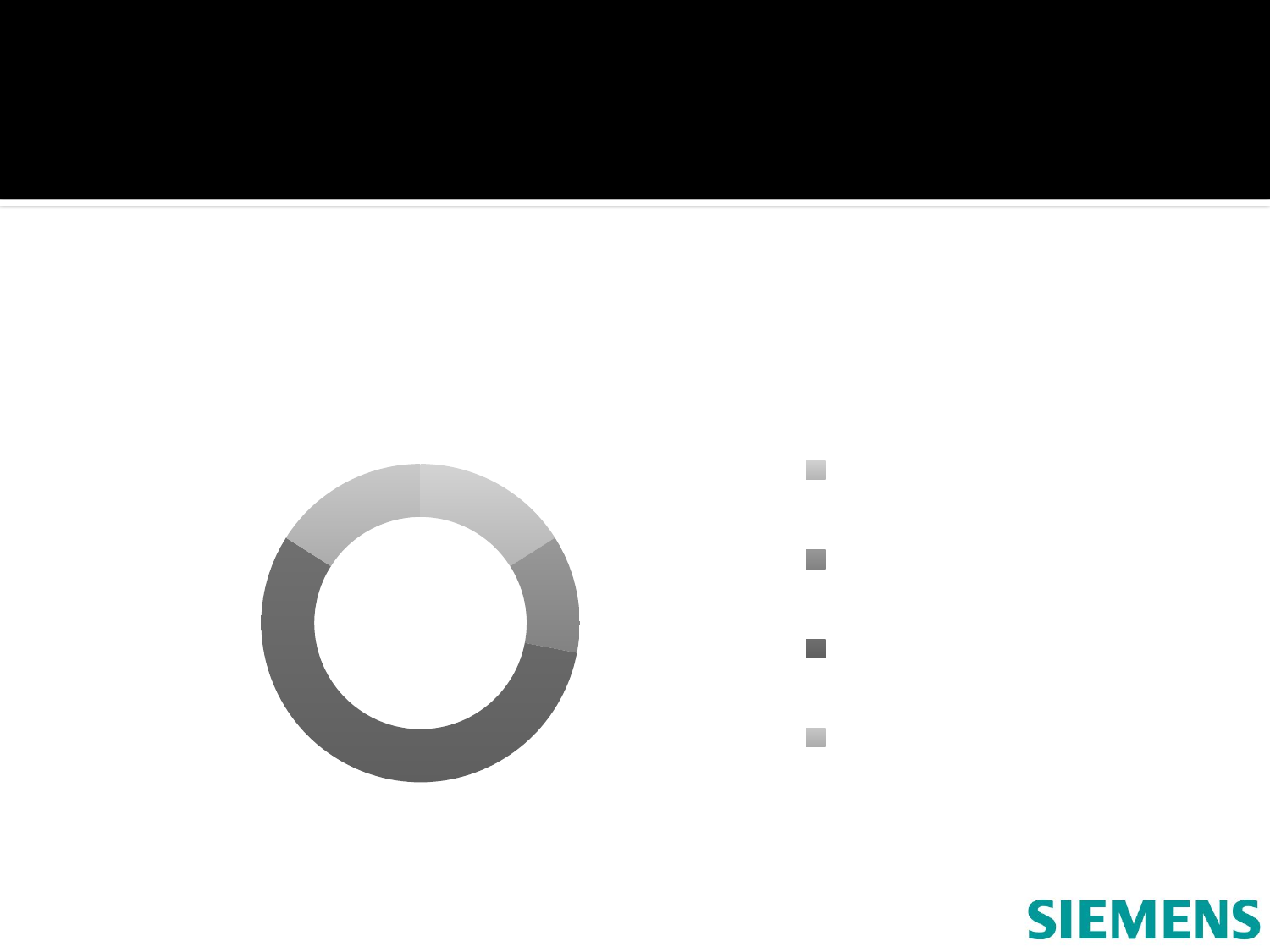
How many entries does the legend to the right of the chart list? 4 How many slices does the doughnut chart have? 4 Is the dark grey slice larger or smaller than all the other slices combined? Larger Does the chart have a visible title? No Which slice of the doughnut chart is the largest? The dark grey slice What kind of chart is shown on the slide? Doughnut chart Does the doughnut chart display data labels on its slices? No